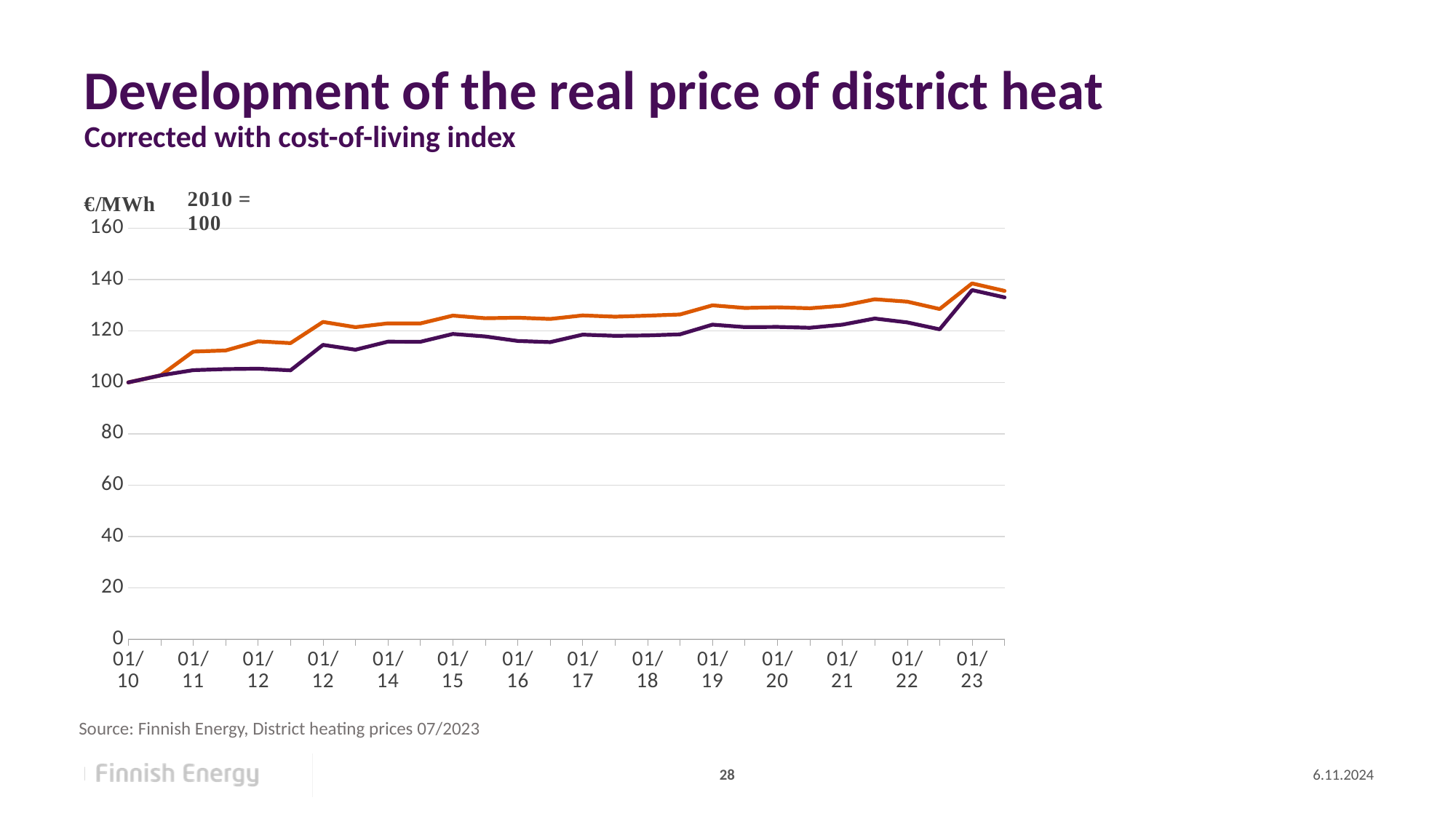
Is the value of the purple line at the first 01/12 point greater or less than 120? less How many lines are plotted on the chart? 2 Is the value of the orange line at 01/19 greater or less than 120? greater What type of chart is shown on the slide? line chart What is the value of both lines at 01/10? 100 At 01/23, which line has the higher value, the orange line or the purple line? the orange line What unit is shown on the y axis of the chart? €/MWh Is the value of the orange line at 01/23 greater or less than 120? greater Do the values of the orange line generally rise or fall from 01/10 to 01/23? rise At which x-axis point does the orange line reach its highest value? 01/23 How many labelled points are there on the x axis? 14